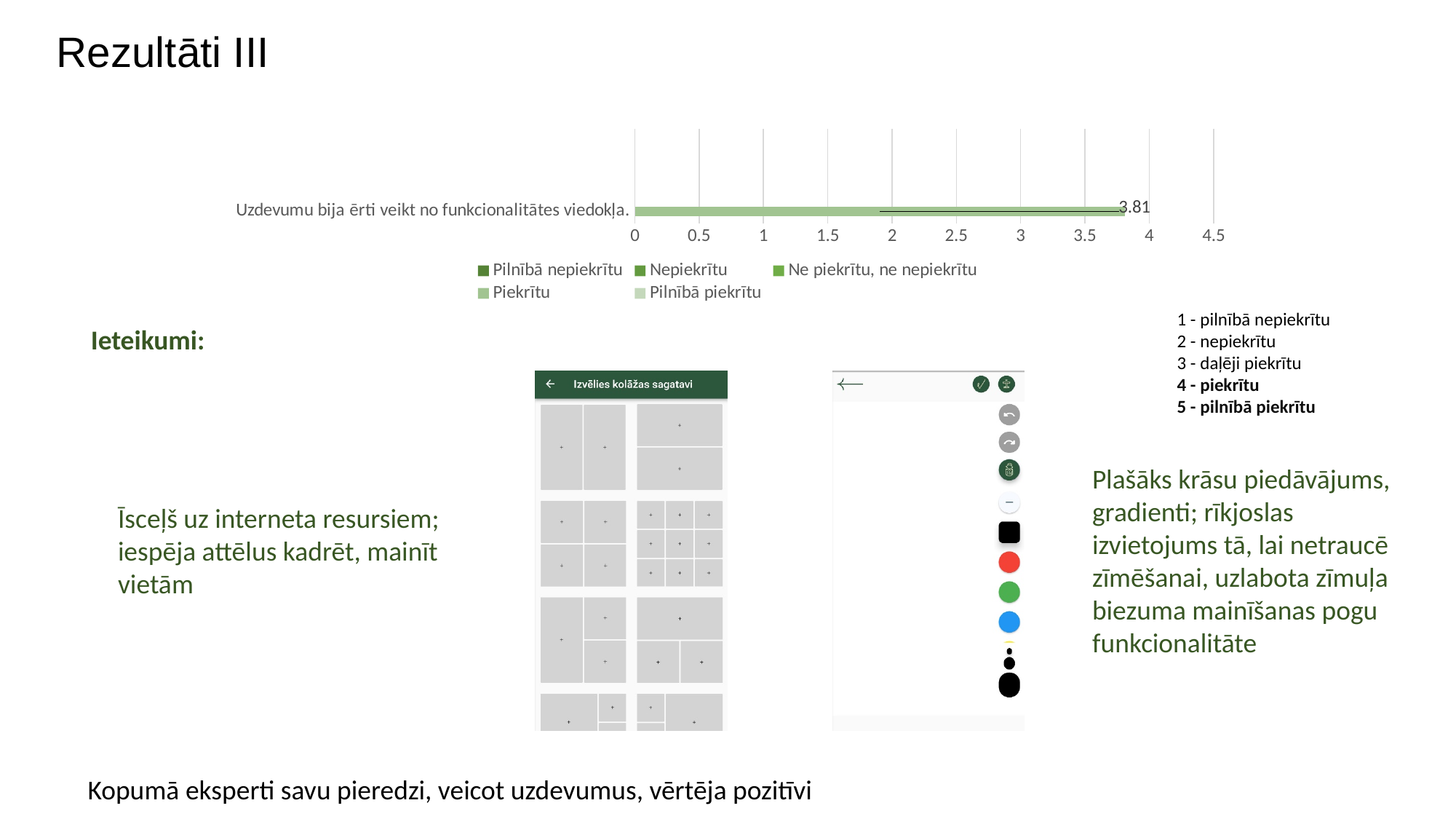
What is the last entry listed in the chart legend? Pilnībā piekrītu What value is shown for "Uzdevumu bija ērti veikt no funkcionalitātes viedokļa."? 3.81 How many categories are plotted in the chart? 1 What is the highest value shown on the chart's horizontal axis? 4.5 What kind of chart is shown on the slide? bar chart How many series does the chart legend list? 5 Is the value for "Uzdevumu bija ērti veikt no funkcionalitātes viedokļa." greater or less than 3.5? greater Is the value for "Uzdevumu bija ērti veikt no funkcionalitātes viedokļa." greater or less than 4? less